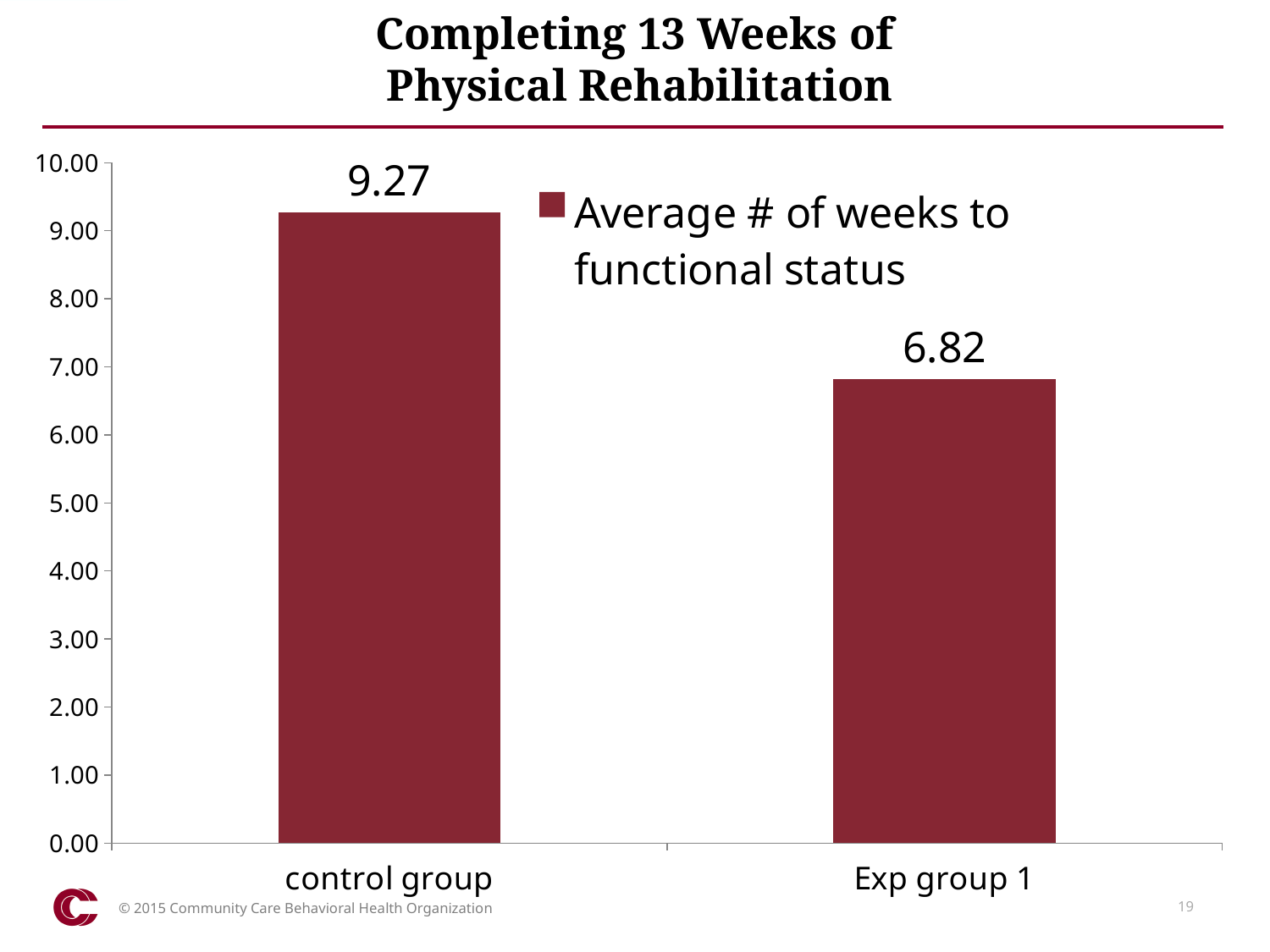
What is the average number of weeks to functional status for the control group? 9.27 Which group has the lower average number of weeks to functional status? Exp group 1 Which group has the higher average number of weeks to functional status? control group Is the value for the control group larger or smaller than the value for Exp group 1? larger What is the average number of weeks to functional status for Exp group 1? 6.82 What kind of chart is shown on the slide? bar chart What is the title of the chart? Completing 13 Weeks of Physical Rehabilitation How many series does the legend list? 1 How many groups are shown on the chart? 2 Is the value for Exp group 1 greater or less than 7.00? less What is the difference between the control group and Exp group 1 values? 2.45 Is the value for the control group greater or less than 9.00? greater